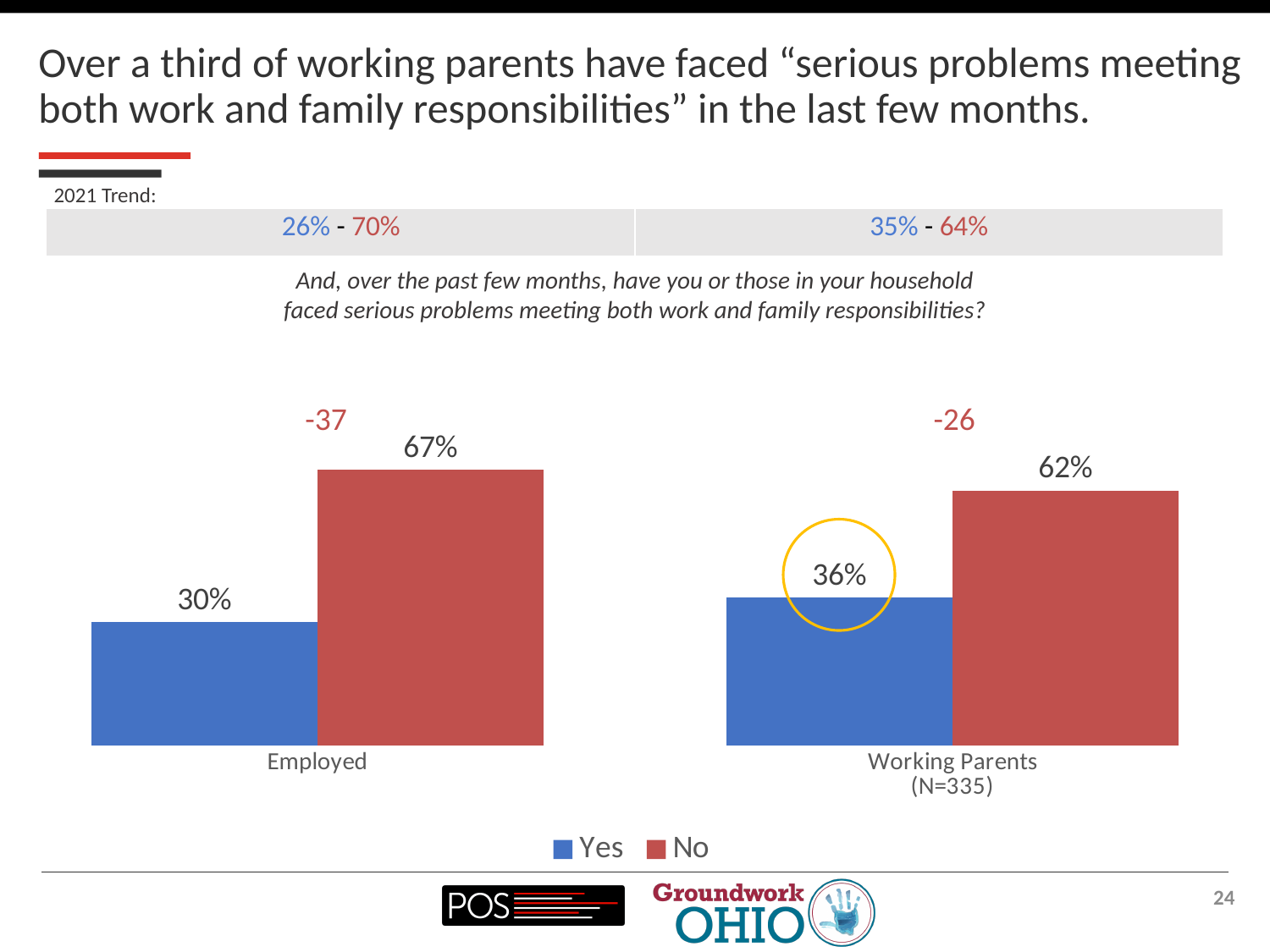
What percentage of Working Parents answered No? 62% How many categories are shown on the x axis? 2 What is the difference between the No and Yes values for Working Parents? 26 What percentage of Working Parents answered Yes? 36% How many series does the legend list? 2 What percentage of Employed respondents answered No? 67% What is the sample size (N) shown for Working Parents? 335 Which category has the higher Yes value, Employed or Working Parents? Working Parents Which category has the higher No value, Employed or Working Parents? Employed What kind of chart is shown on the slide? Bar chart What percentage of Employed respondents answered Yes? 30% What is the difference between the No and Yes values for Employed respondents? 37